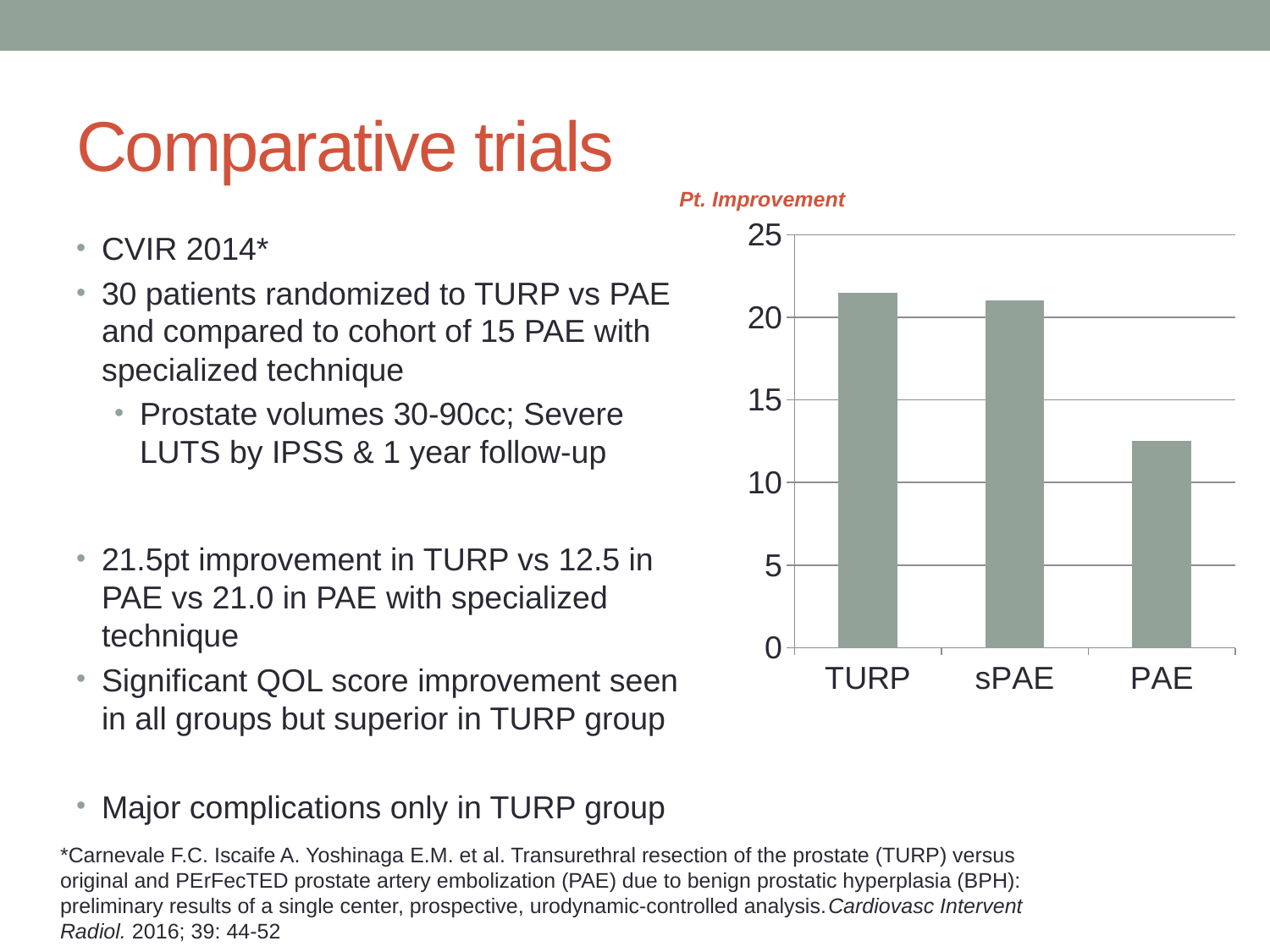
Is the value for sPAE greater or less than 20? greater What is the title of the chart? Pt. Improvement Is the value for TURP greater or less than 20? greater Is the value for PAE greater or less than 15? less Which is larger, the value for TURP or the value for PAE? TURP Which category has the lowest bar in the chart? PAE Which is larger, the value for sPAE or the value for PAE? sPAE What is the highest tick value shown on the y axis of the chart? 25 How many categories are shown on the x axis of the chart? 3 What kind of chart is shown on the slide? bar chart